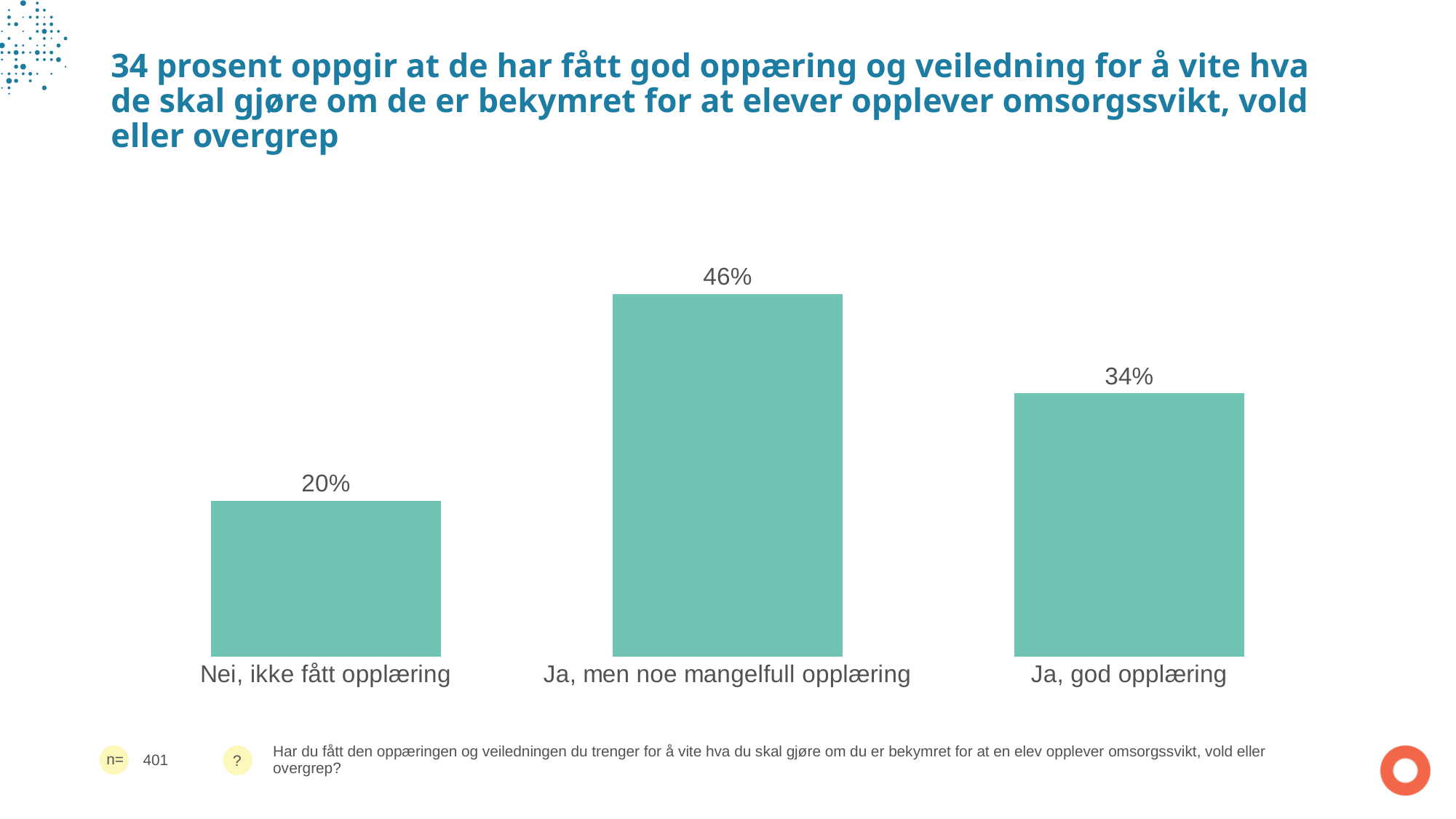
What is the value for "Nei, ikke fått opplæring"? 20% What is the difference between the values for "Ja, men noe mangelfull opplæring" and "Ja, god opplæring"? 12% What is the value for "Ja, men noe mangelfull opplæring"? 46% How many categories are shown in the chart? 3 What is the difference between the values for "Ja, god opplæring" and "Nei, ikke fått opplæring"? 14% What colour are the bars in the chart? Teal (green) Which is larger: the value for "Ja, god opplæring" or the value for "Nei, ikke fått opplæring"? Ja, god opplæring What is the value for "Ja, god opplæring"? 34% What kind of chart is shown on the slide? Bar chart What is the sample size (n) shown on the slide? 401 Which category has the highest value? Ja, men noe mangelfull opplæring Which category has the lowest value? Nei, ikke fått opplæring